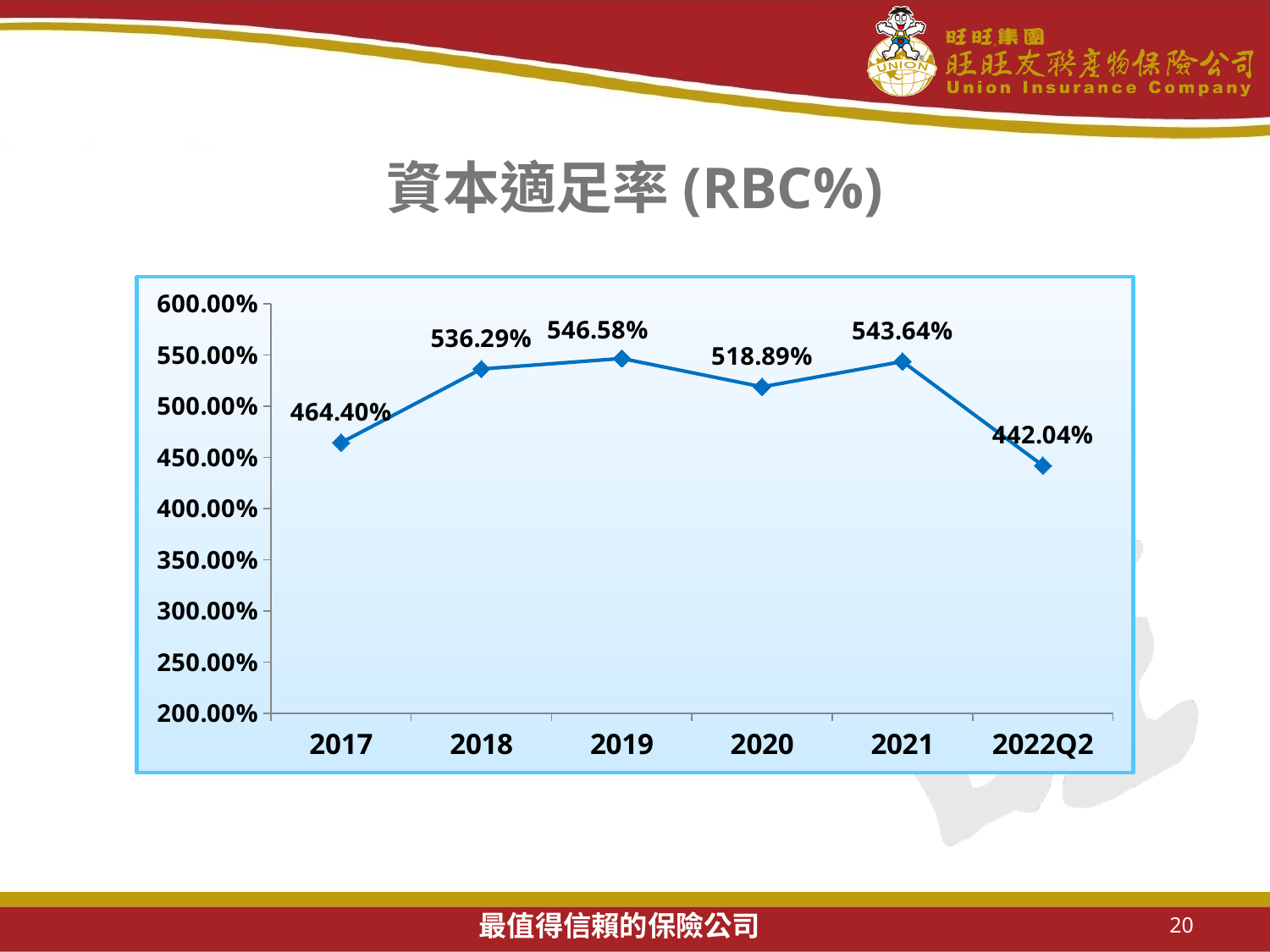
What is the RBC% value for 2022Q2? 442.04% Which period has the highest RBC% value? 2019 What is the title of the chart? 資本適足率 (RBC%) What is the difference between the RBC% values for 2019 and 2017? 82.18% What is the RBC% value for 2017? 464.40% What is the RBC% value for 2020? 518.89% What kind of chart is shown on the slide? line chart Is the RBC% value for 2017 greater or less than 500.00%? less Which period has the lowest RBC% value? 2022Q2 Which is larger, the RBC% value for 2018 or for 2020? 2018 How many periods are plotted on the x axis? 6 What is the difference between the RBC% values for 2021 and 2022Q2? 101.60%